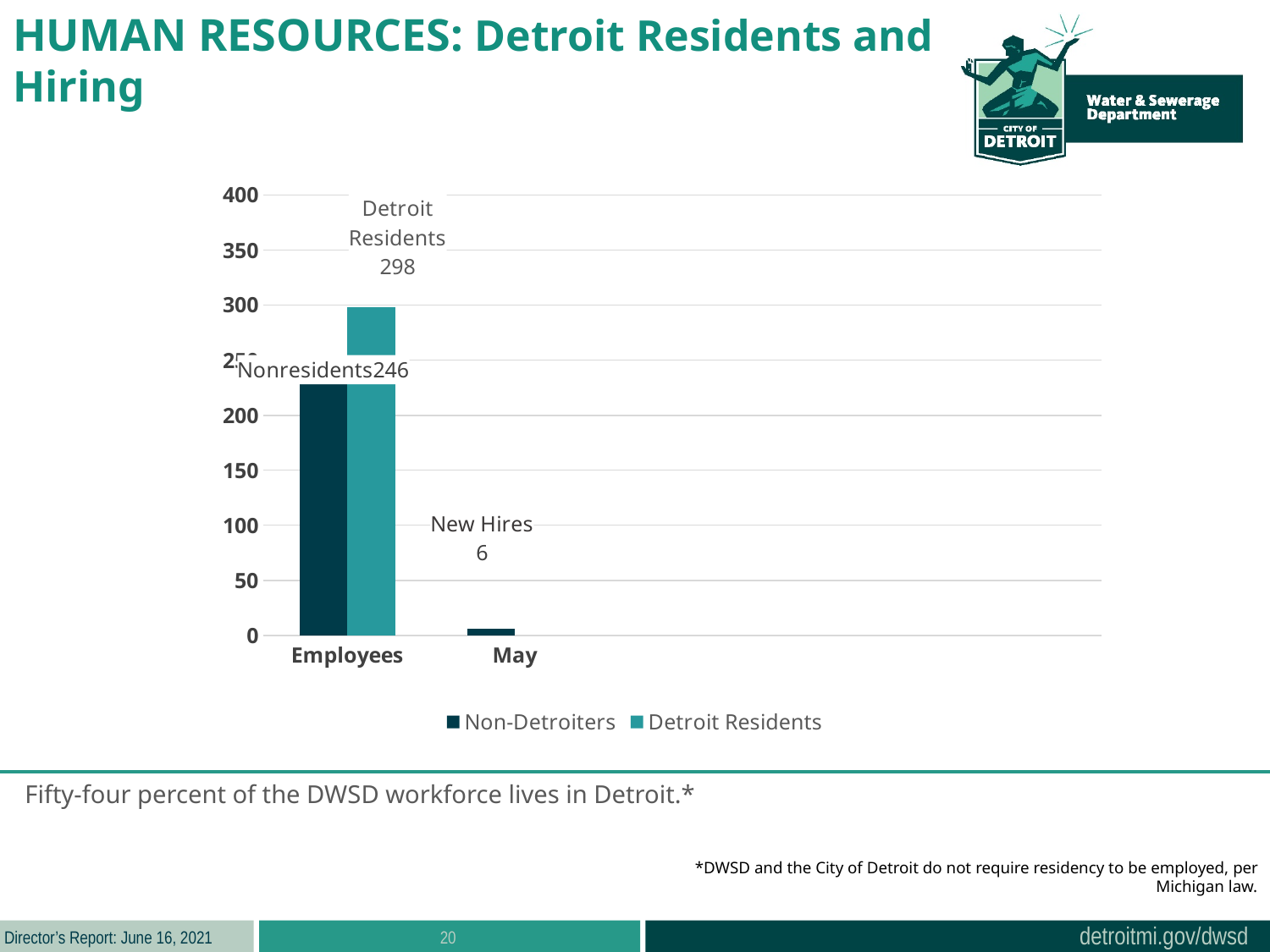
In the Employees category, which is larger: Detroit Residents or Non-Detroiters? Detroit Residents Is the value for Non-Detroiters in the Employees category greater or less than 200? greater How many categories are shown on the x axis? 2 How many series does the legend list? 2 What is the value for Detroit Residents in the Employees category? 298 Which bar is the tallest on the chart? Detroit Residents (Employees) What is the difference between Detroit Residents and Nonresidents in the Employees category? 52 What are the two legend entries of the chart? Non-Detroiters and Detroit Residents How many new hires are shown for May? 6 What kind of chart is shown on the slide? bar chart What is the value for Non-Detroiters (Nonresidents) in the Employees category? 246 Is the value for Detroit Residents in the Employees category greater or less than 300? less